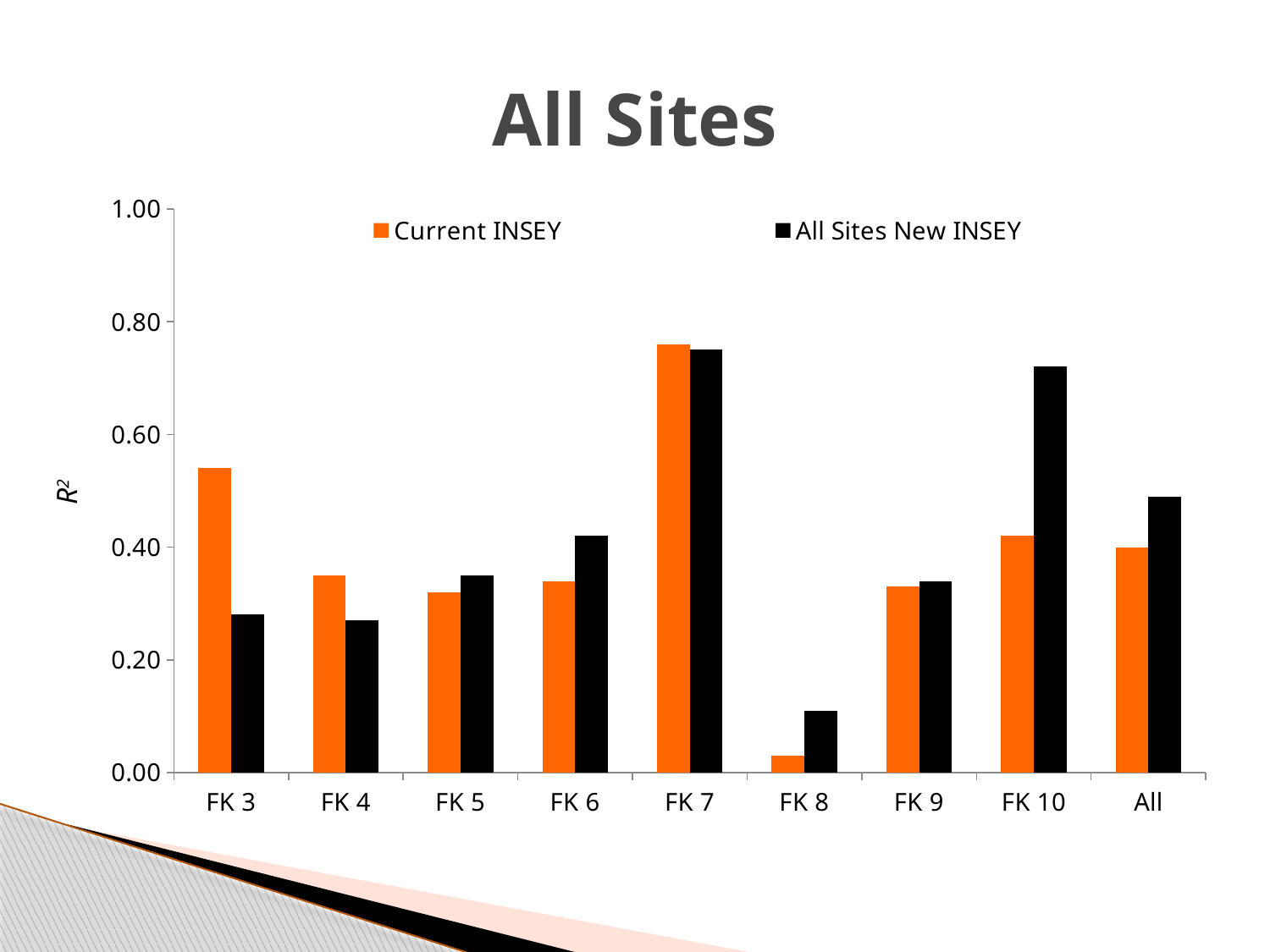
How many series does the legend list? 2 Is the All Sites New INSEY value for FK 8 greater or less than 0.20? less Which category has the highest Current INSEY value? FK 7 For FK 10, which is larger: Current INSEY or All Sites New INSEY? All Sites New INSEY For FK 3, which is larger: Current INSEY or All Sites New INSEY? Current INSEY Is the Current INSEY value for FK 3 greater or less than 0.40? greater What kind of chart is shown on the slide? bar chart How many categories are shown on the x axis? 9 What is the label on the y axis? R² Which category has the lowest All Sites New INSEY value? FK 8 Which category has the lowest Current INSEY value? FK 8 Is the All Sites New INSEY value for FK 10 greater or less than 0.60? greater